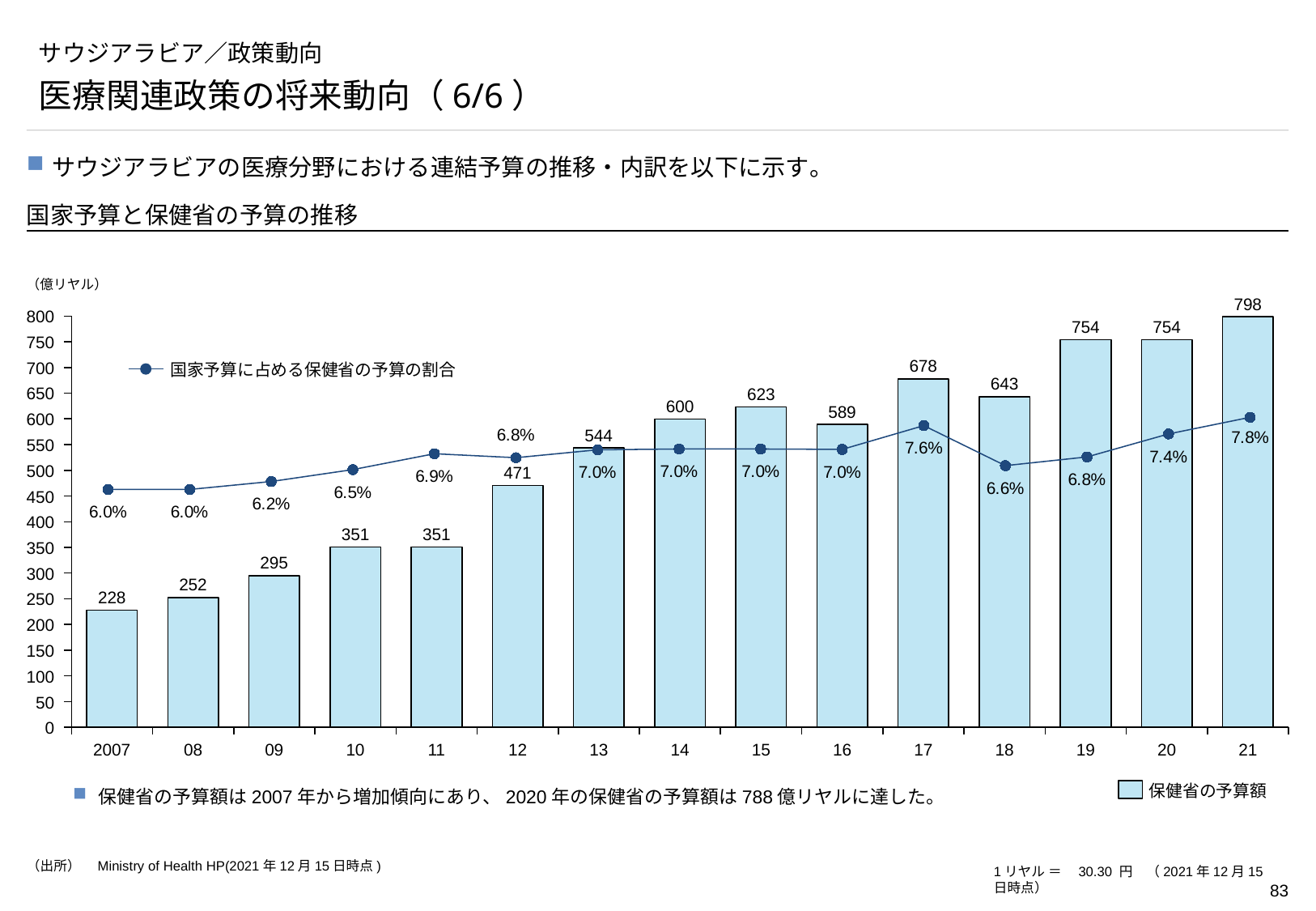
What kind of chart is used to show the 保健省の予算額? Bar chart What is the 保健省の予算額 value shown for 21? 798 Which is larger, the 保健省の予算額 for 15 or for 16? 15 What is the difference between the 保健省の予算額 for 17 and for 18? 35 How many years are shown on the x axis of the chart? 15 What is the 保健省の予算額 (Ministry of Health budget) for 2007? 228 Which year has the lowest 保健省の予算額? 2007 Does the 保健省の予算額 generally rise or fall from 2007 to 21? Rise Which year has the highest 保健省の予算額? 21 What is the unit shown above the y axis of the chart? 億リヤル What is the 国家予算に占める保健省の予算の割合 (share of national budget) shown for 17? 7.6% What is the lowest 国家予算に占める保健省の予算の割合 value shown on the line? 6.0%